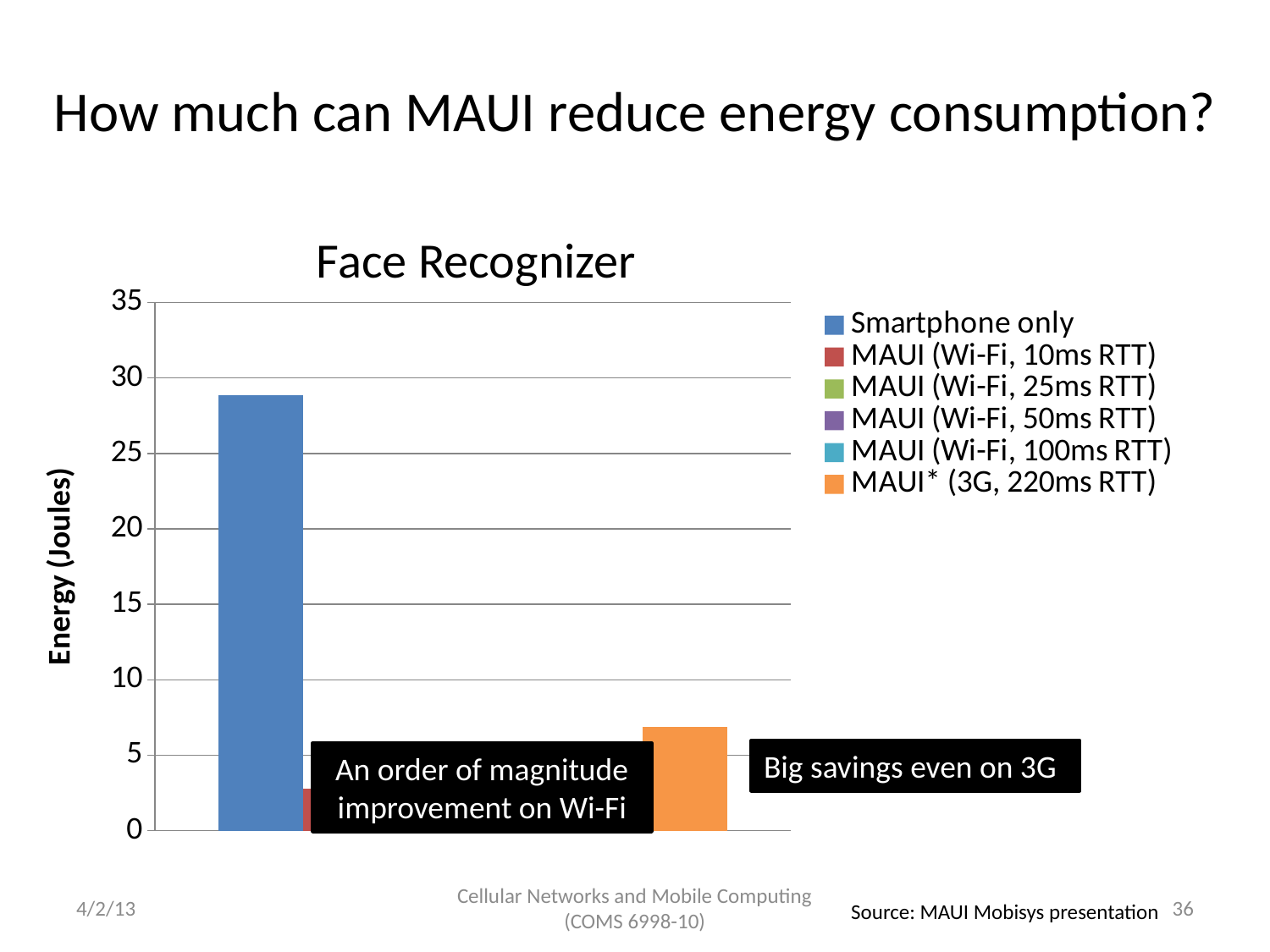
Which series has the highest energy value in the chart? Smartphone only What is the highest value shown on the vertical axis of the chart? 35 What kind of chart is shown on the slide? bar chart What is the title of the chart? Face Recognizer Is the energy value for Smartphone only greater or less than 30? less Is the energy value for MAUI* (3G, 220ms RTT) greater or less than 5? greater Which has the larger energy value, Smartphone only or MAUI* (3G, 220ms RTT)? Smartphone only Is the energy value for Smartphone only greater or less than 25? greater Which has the larger energy value, MAUI* (3G, 220ms RTT) or MAUI (Wi-Fi, 10ms RTT)? MAUI* (3G, 220ms RTT) How many series does the chart's legend list? 6 What is the label of the vertical axis? Energy (Joules)